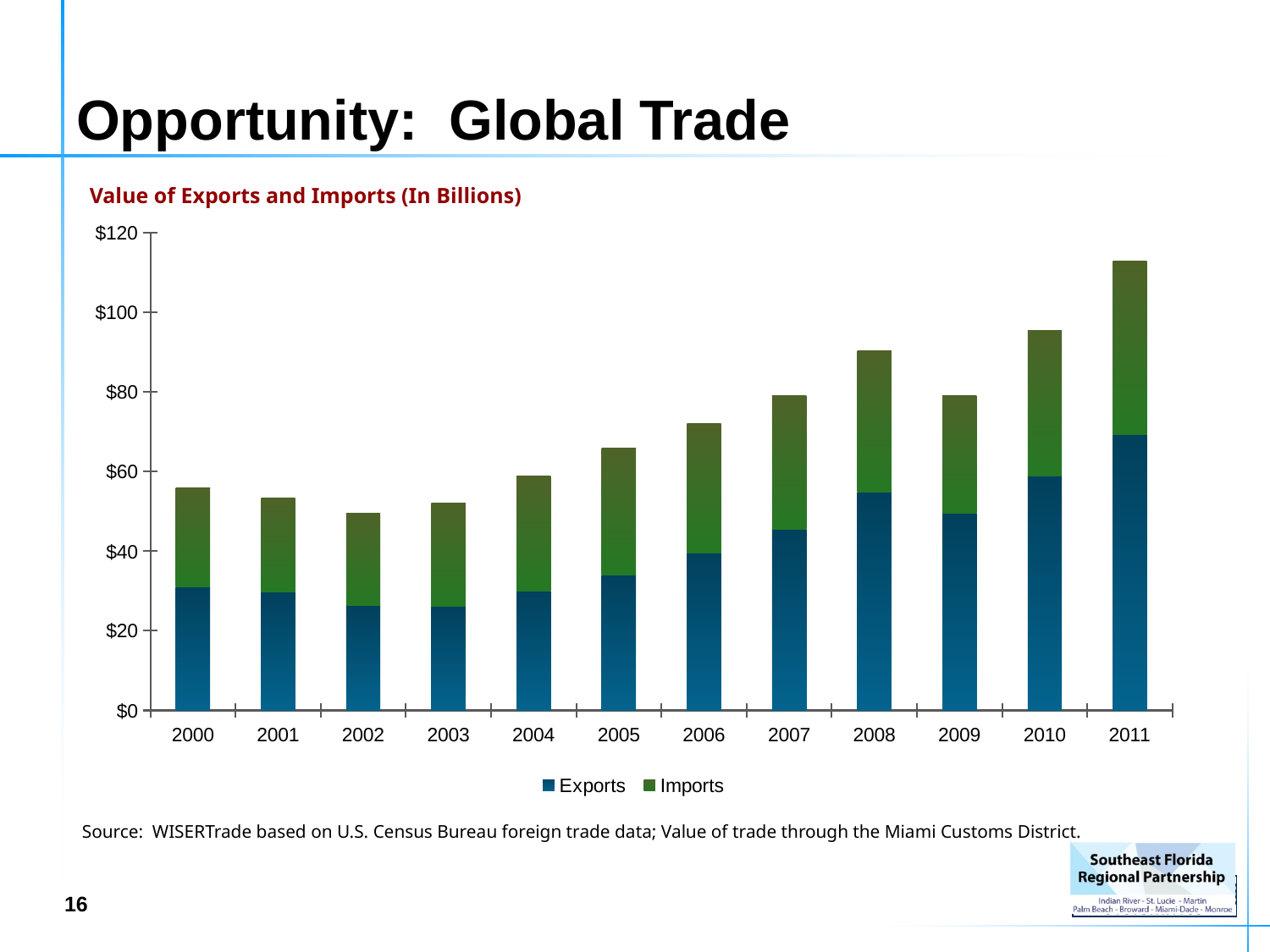
How many years are shown on the x axis of the chart? 12 Is the total value of exports and imports for 2011 greater or less than $100? greater Do the total values of exports and imports rise or fall from 2002 to 2008? rise Is the value of exports for 2008 greater or less than $40? greater Is the value of exports for 2011 greater or less than $60? greater Which year has the highest value of exports? 2011 What is the title of the chart? Value of Exports and Imports (In Billions) What kind of chart is shown on the slide? Stacked bar chart Which year has the highest total value of exports and imports? 2011 Which year has the larger total value of exports and imports, 2008 or 2009? 2008 How many series does the chart's legend list? 2